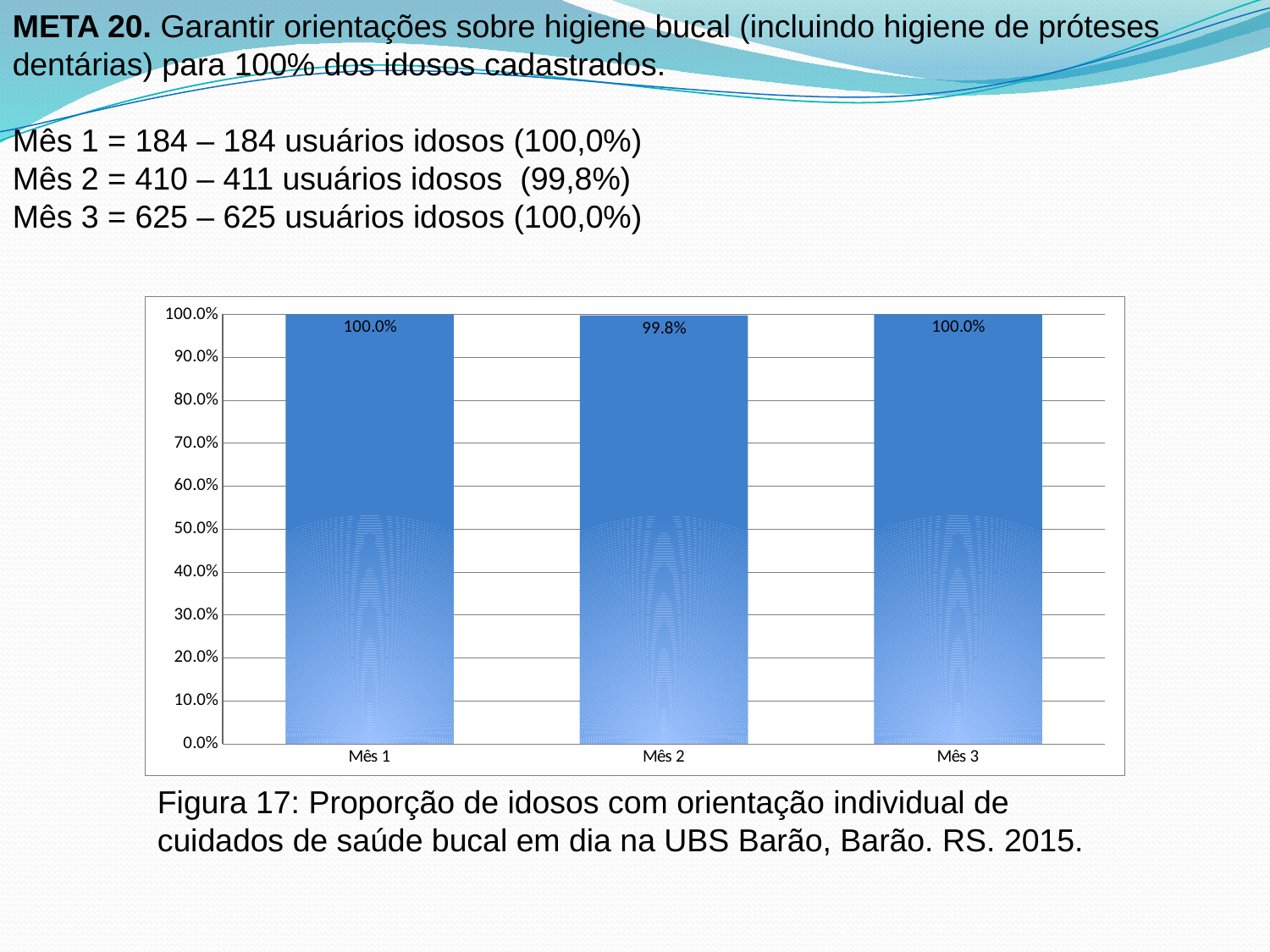
Does the value rise or fall from Mês 2 to Mês 3? rise What is the difference between the values for Mês 1 and Mês 2? 0.2% What is the highest tick value shown on the y axis? 100.0% Which is larger, the value for Mês 2 or the value for Mês 3? Mês 3 Which month has the lowest value in the chart? Mês 2 What is the value shown for Mês 3? 100.0% What kind of chart is shown on the slide? bar chart What is the value shown for Mês 1? 100.0% How many months (categories) are shown on the x axis? 3 Is the value for Mês 2 greater or less than 90.0%? greater What is the figure number given in the caption below the chart? Figura 17 What is the value shown for Mês 2? 99.8%